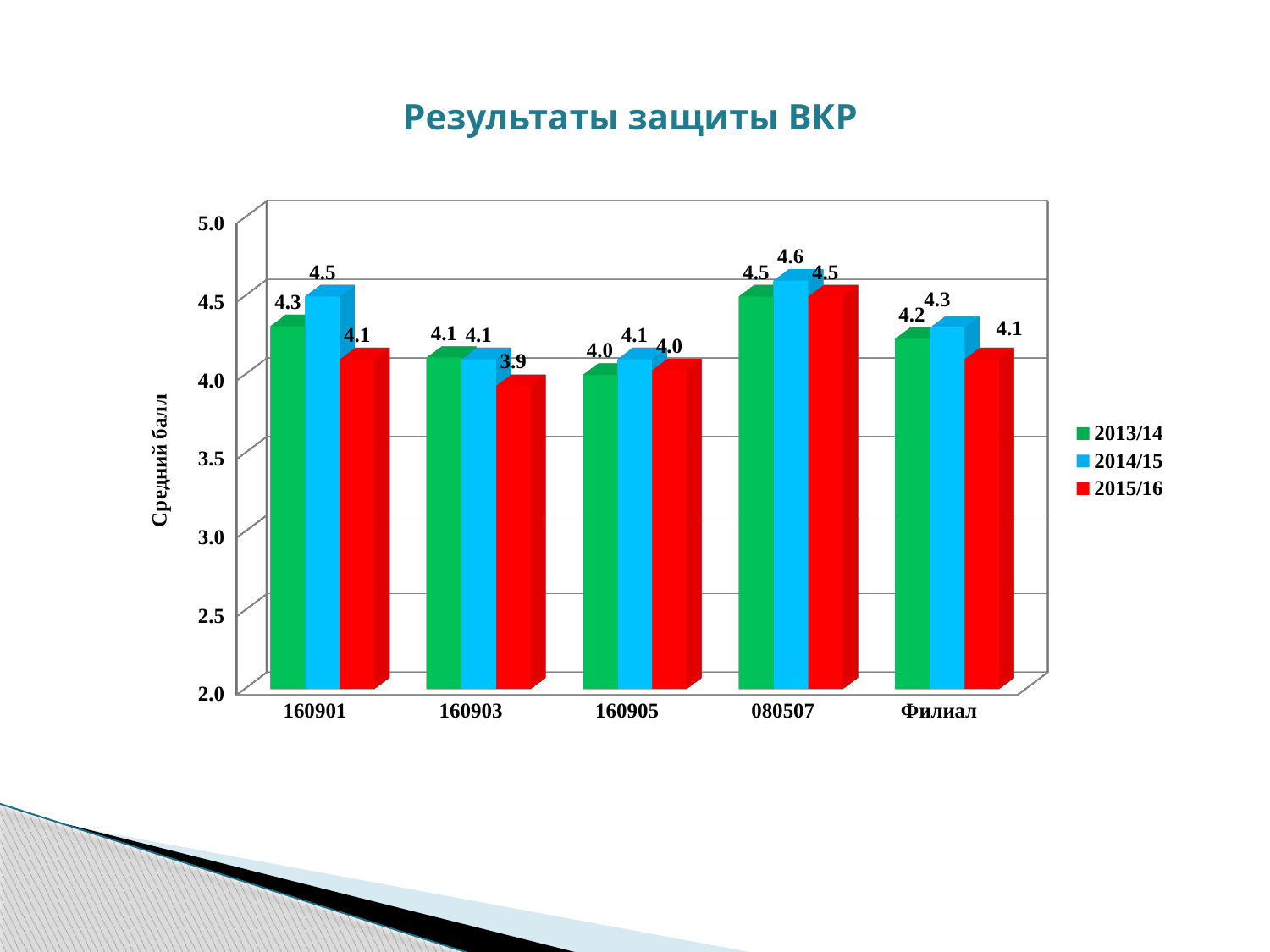
How many categories are shown on the x axis? 5 What is the value for 160901 in the 2014/15 series? 4.5 Which is larger for 080507: the 2014/15 value or the 2015/16 value? 2014/15 What is the value for 160903 in the 2015/16 series? 3.9 Which category has the lowest value in the 2015/16 series? 160903 How many series does the legend list? 3 What is the label of the vertical axis? Средний балл What kind of chart is shown on the slide? bar chart What is the value for Филиал in the 2013/14 series? 4.2 What is the title of the chart? Результаты защиты ВКР Which category has the highest value in the 2014/15 series? 080507 What is the difference between the 2014/15 and 2013/14 values for 160901? 0.2